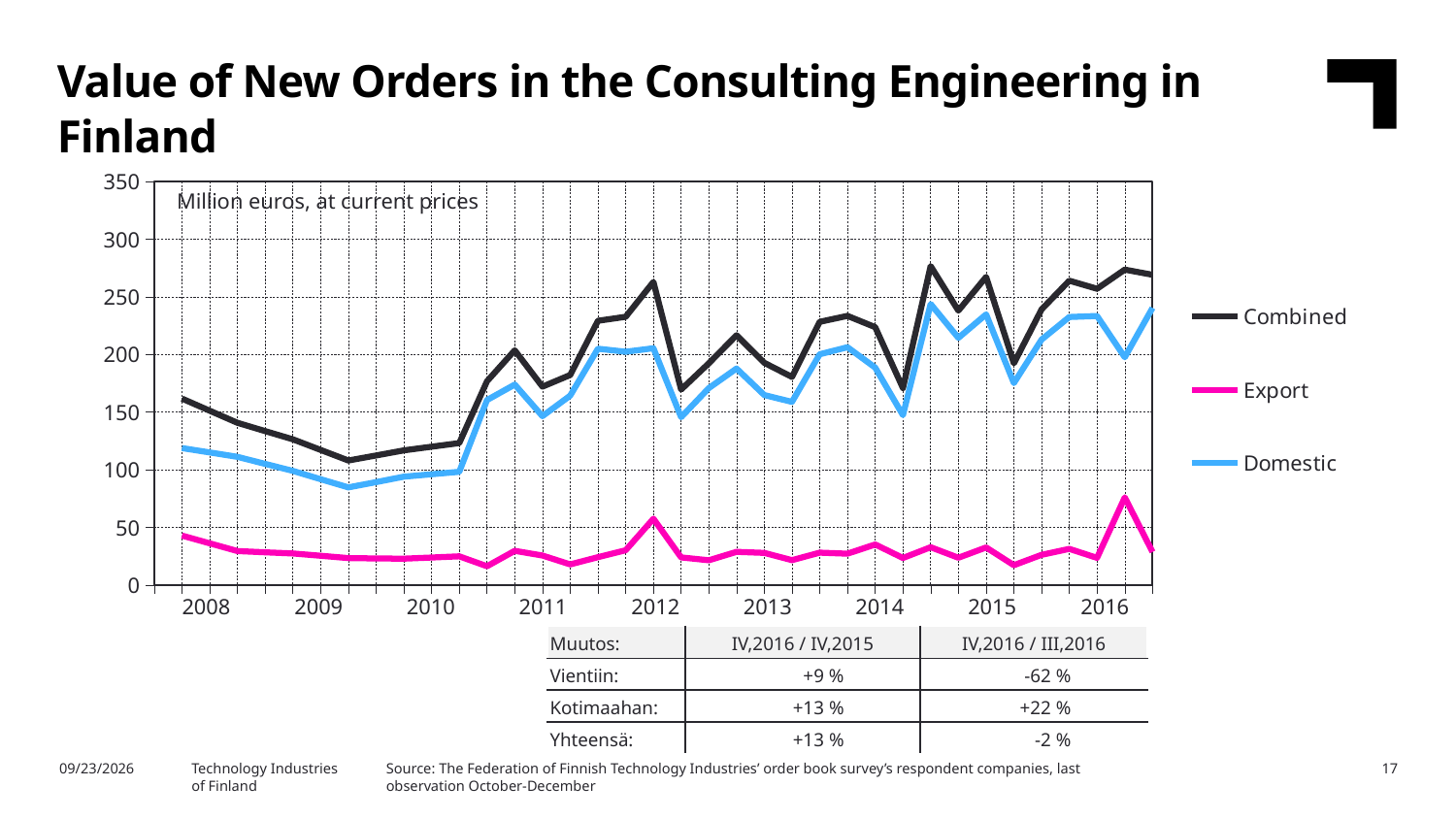
What are the three series named in the legend? Combined, Export, Domestic Is the highest Combined value in 2014 greater or less than 300? less Which series has the lowest values throughout the chart? Export Does the Combined series rise or fall from 2008 to 2009? fall What unit is stated in the text box inside the chart? Million euros, at current prices What type of chart is shown on the slide? line chart How many years are labelled on the x axis? 9 Is the Export value at its 2016 peak greater or less than 100? less Which is larger in 2013, the Domestic value or the Export value? Domestic How many series does the legend list? 3 Which series has the highest values throughout the chart? Combined Is the Domestic value at its 2014 peak greater or less than 200? greater